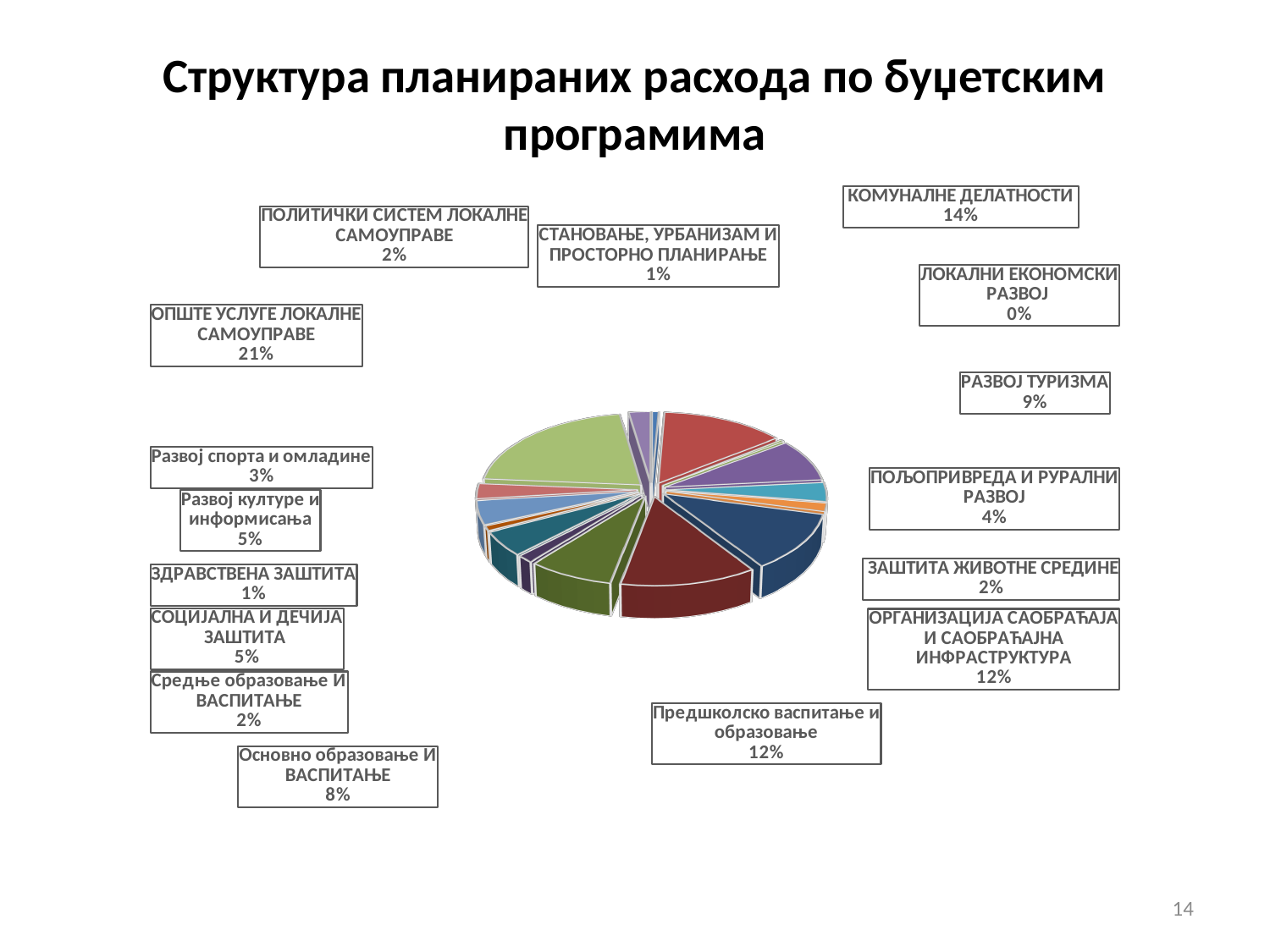
Which budget programme has the smallest share of planned expenditure? ЛОКАЛНИ ЕКОНОМСКИ РАЗВОЈ What is the difference in percentage points between ОПШТЕ УСЛУГЕ ЛОКАЛНЕ САМОУПРАВЕ and КОМУНАЛНЕ ДЕЛАТНОСТИ? 7 percentage points What percentage is shown for ОРГАНИЗАЦИЈА САОБРАЋАЈА И САОБРАЋАЈНА ИНФРАСТРУКТУРА? 12% Which has a larger share: Предшколско васпитање и образовање or Основно образовање И ВАСПИТАЊЕ? Предшколско васпитање и образовање What percentage is shown for РАЗВОЈ ТУРИЗМА? 9% What percentage is shown for Основно образовање И ВАСПИТАЊЕ? 8% What percentage is shown for ПОЉОПРИВРЕДА И РУРАЛНИ РАЗВОЈ? 4% What kind of chart is shown on the slide? Pie chart Which budget programme has the largest share of planned expenditure? ОПШТЕ УСЛУГЕ ЛОКАЛНЕ САМОУПРАВЕ How many budget programmes are labelled on the pie chart? 16 What is the title of the slide? Структура планираних расхода по буџетским програмима What share of planned expenditure goes to КОМУНАЛНЕ ДЕЛАТНОСТИ? 14%